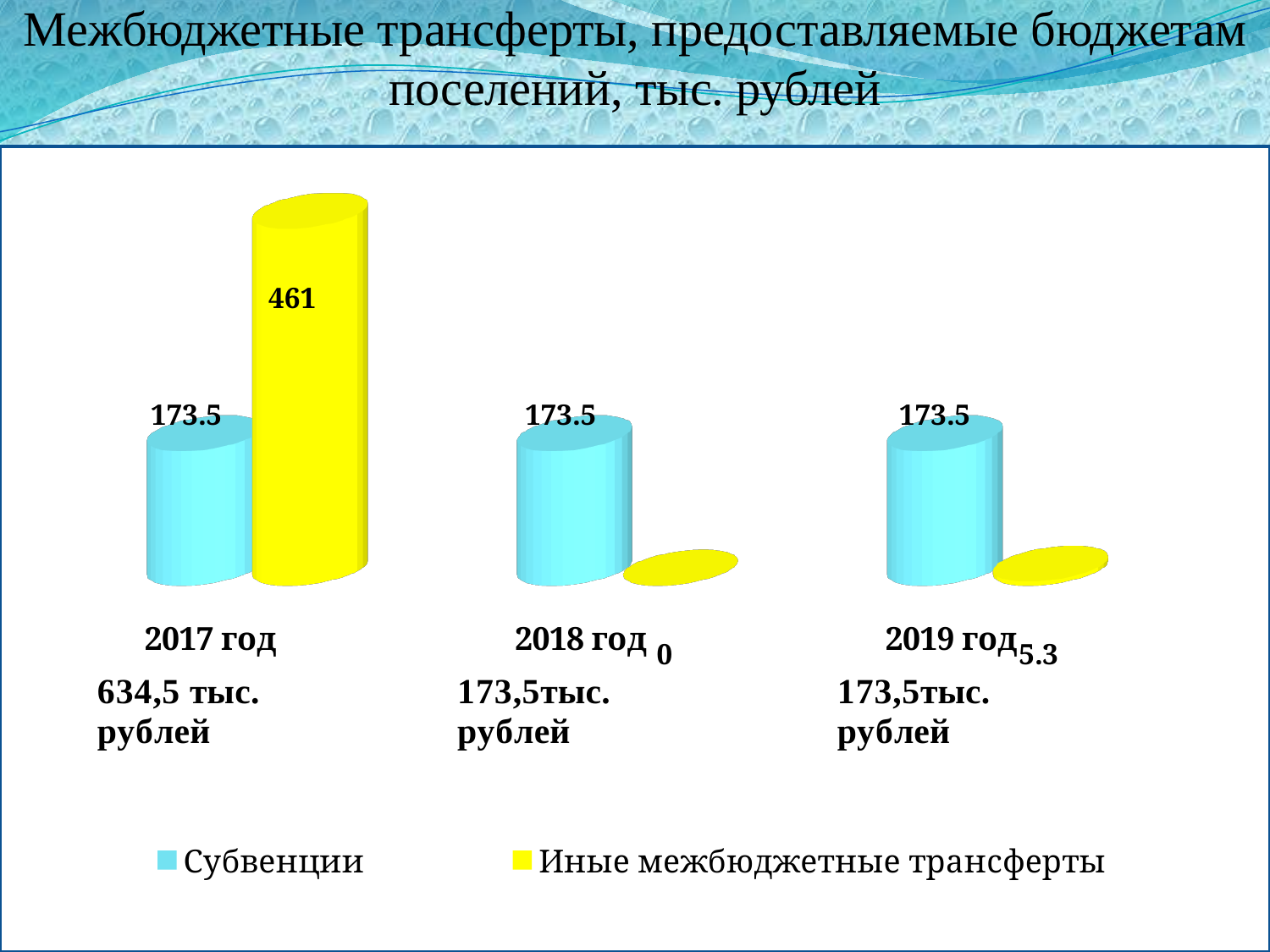
In which year is the value of Иные межбюджетные трансферты the highest? 2017 год What is the value of Иные межбюджетные трансферты for 2017 год? 461 What total amount is written under 2017 год? 634,5 тыс. рублей How many series does the legend list? 2 What kind of chart is shown on the slide? bar chart What is the difference between Иные межбюджетные трансферты and Субвенции in 2017 год? 287.5 In 2017 год, which series has the larger value, Субвенции or Иные межбюджетные трансферты? Иные межбюджетные трансферты What is the value of Иные межбюджетные трансферты for 2019 год? 5.3 What is the value of Иные межбюджетные трансферты for 2018 год? 0 What is the value of Субвенции for 2017 год? 173.5 How does the value of Субвенции change from 2017 год to 2019 год? It stays the same How many years are shown on the chart? 3